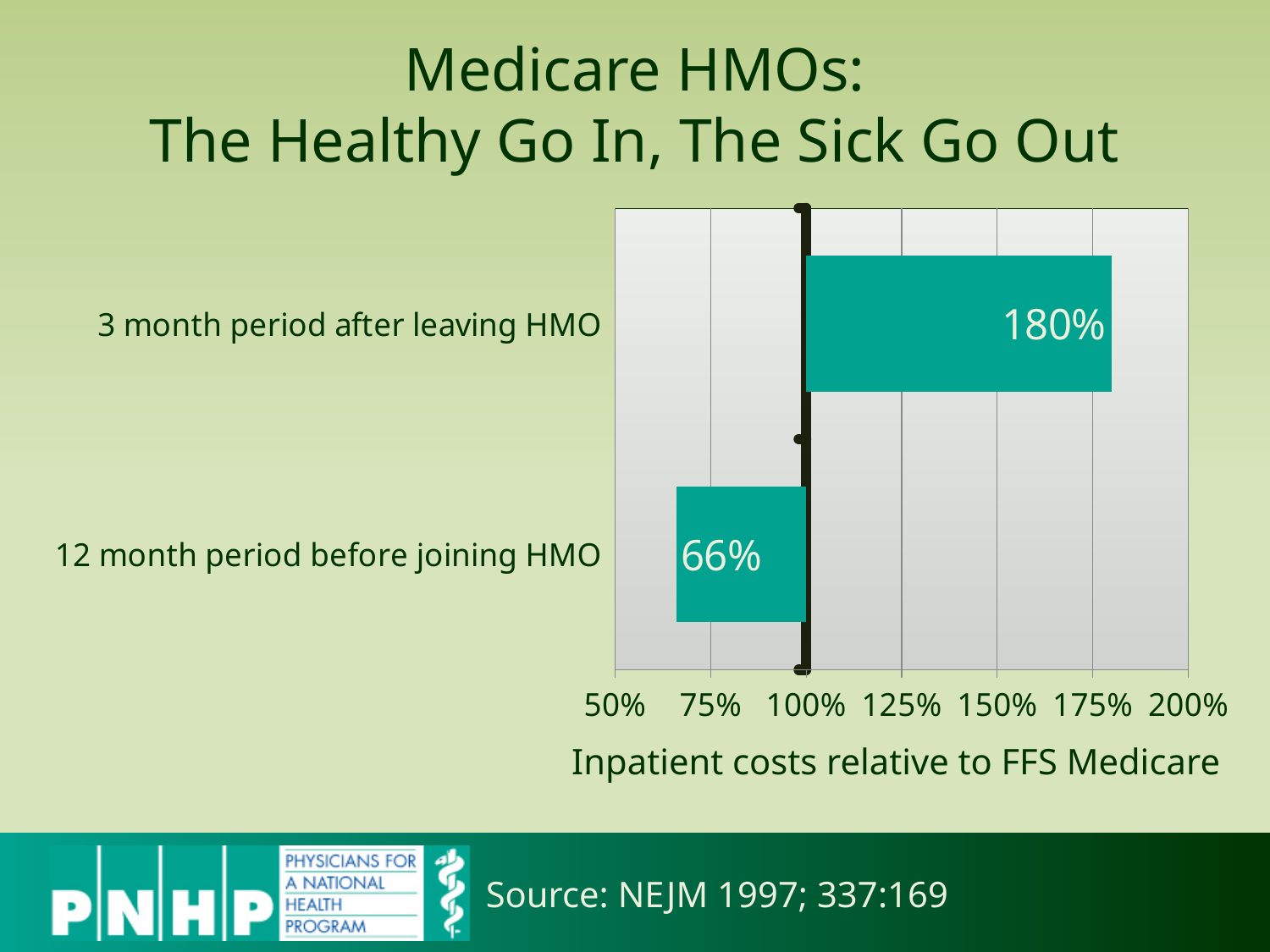
How many categories are shown in the chart? 2 Is the value for the 3 month period after leaving HMO greater or less than 150%? greater What kind of chart is shown on the slide? bar chart Is the value for the 12 month period before joining HMO greater or less than 100%? less What is the difference between the value for the 3 month period after leaving HMO and the 12 month period before joining HMO? 114% Which category has the highest value? 3 month period after leaving HMO Which is larger: the value for the 3 month period after leaving HMO or the 12 month period before joining HMO? 3 month period after leaving HMO What is the title of the slide? Medicare HMOs: The Healthy Go In, The Sick Go Out Which category has the lowest value? 12 month period before joining HMO What is the label of the horizontal axis? Inpatient costs relative to FFS Medicare What is the value for the 3 month period after leaving HMO? 180% What is the value for the 12 month period before joining HMO? 66%